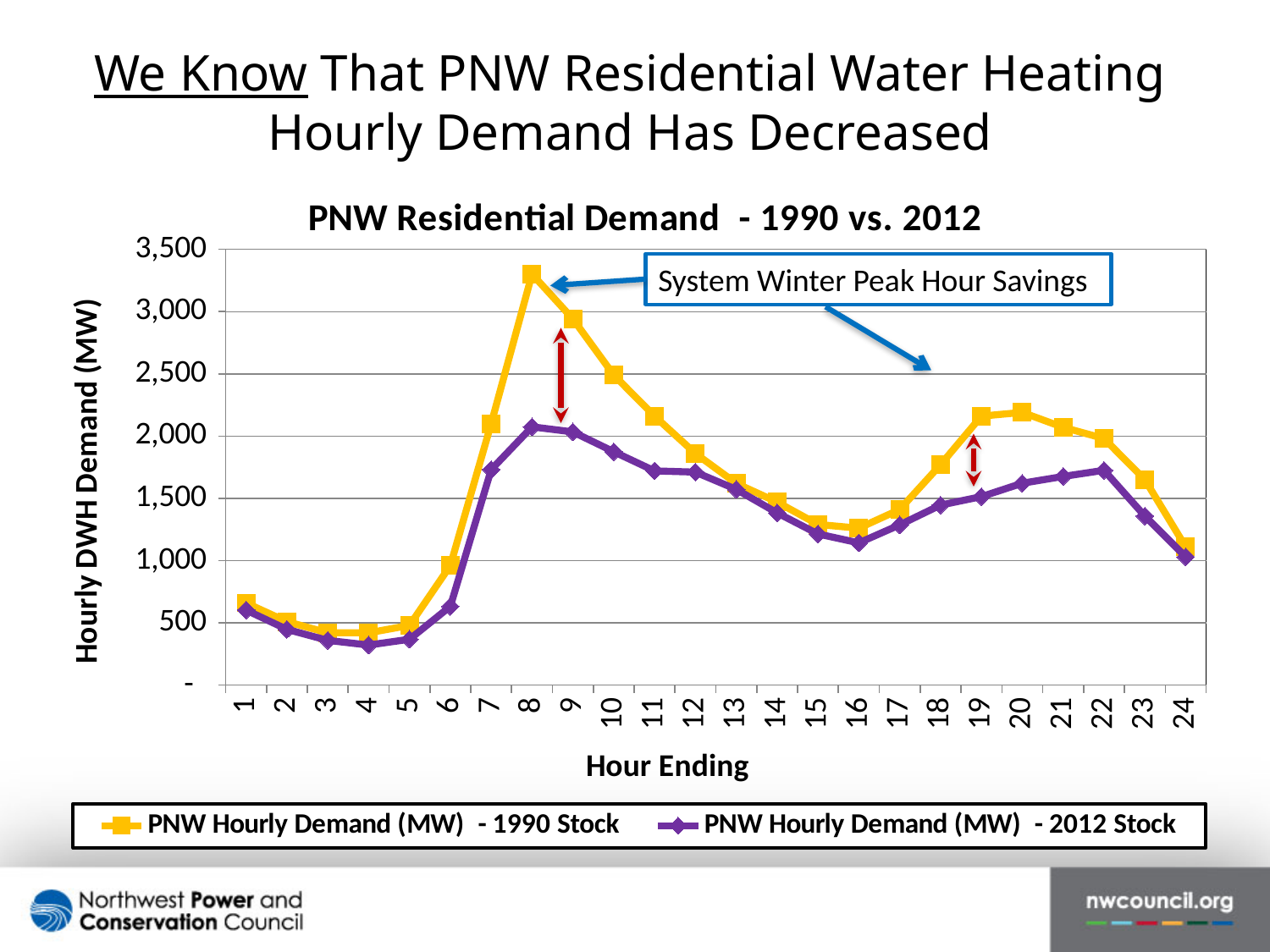
How many hours are plotted along the x axis? 24 What kind of chart is shown on the slide? Line chart Between hour ending 8 and hour ending 16, does the 1990 Stock series rise or fall? Fall Is the value for the 1990 Stock series at hour ending 8 greater or less than 3,000? greater At which hour ending does the PNW Hourly Demand (MW) - 1990 Stock series reach its highest value? 8 How many series does the legend list? 2 What is the title of the chart? PNW Residential Demand - 1990 vs. 2012 At hour ending 9, which series has the larger value, 1990 Stock or 2012 Stock? 1990 Stock Is the value for the 1990 Stock series at hour ending 16 greater or less than 1,500? less At which hour ending does the PNW Hourly Demand (MW) - 2012 Stock series reach its lowest value? 4 Is the value for the 2012 Stock series at hour ending 4 greater or less than 500? less